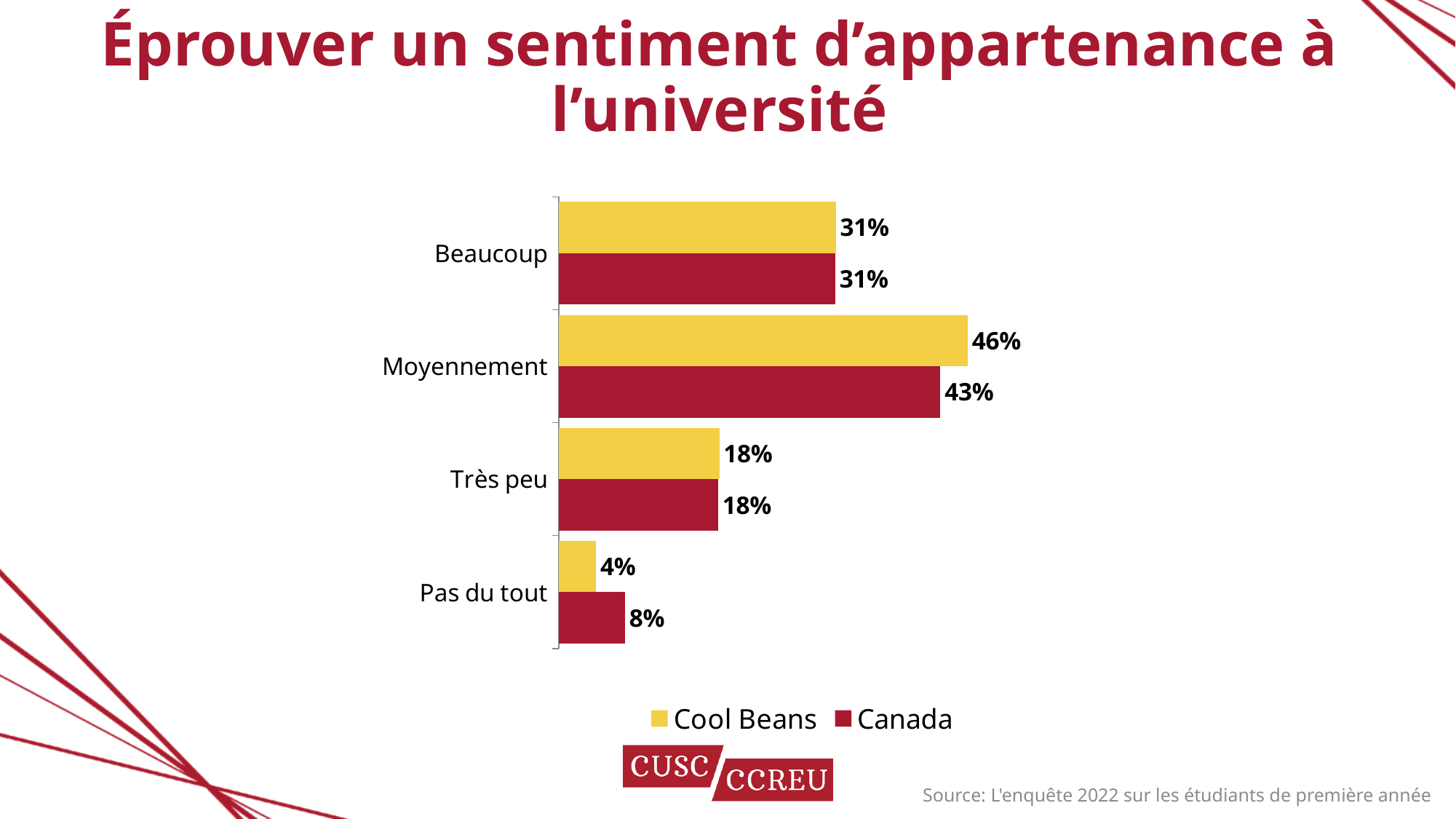
What kind of chart is shown on the slide? Bar chart What is the value for Cool Beans in the Moyennement category? 46% What is the value for Canada in the Pas du tout category? 8% What is the difference between the Cool Beans and Canada values in the Moyennement category? 3% How many series does the legend list? 2 What is the value for Cool Beans in the Très peu category? 18% How many categories are shown on the chart? 4 In the Pas du tout category, which series has the larger value, Cool Beans or Canada? Canada Which category has the highest value for Cool Beans? Moyennement Which category has the lowest value for Canada? Pas du tout What is the difference between the Canada and Cool Beans values in the Pas du tout category? 4% What is the value for Canada in the Beaucoup category? 31%